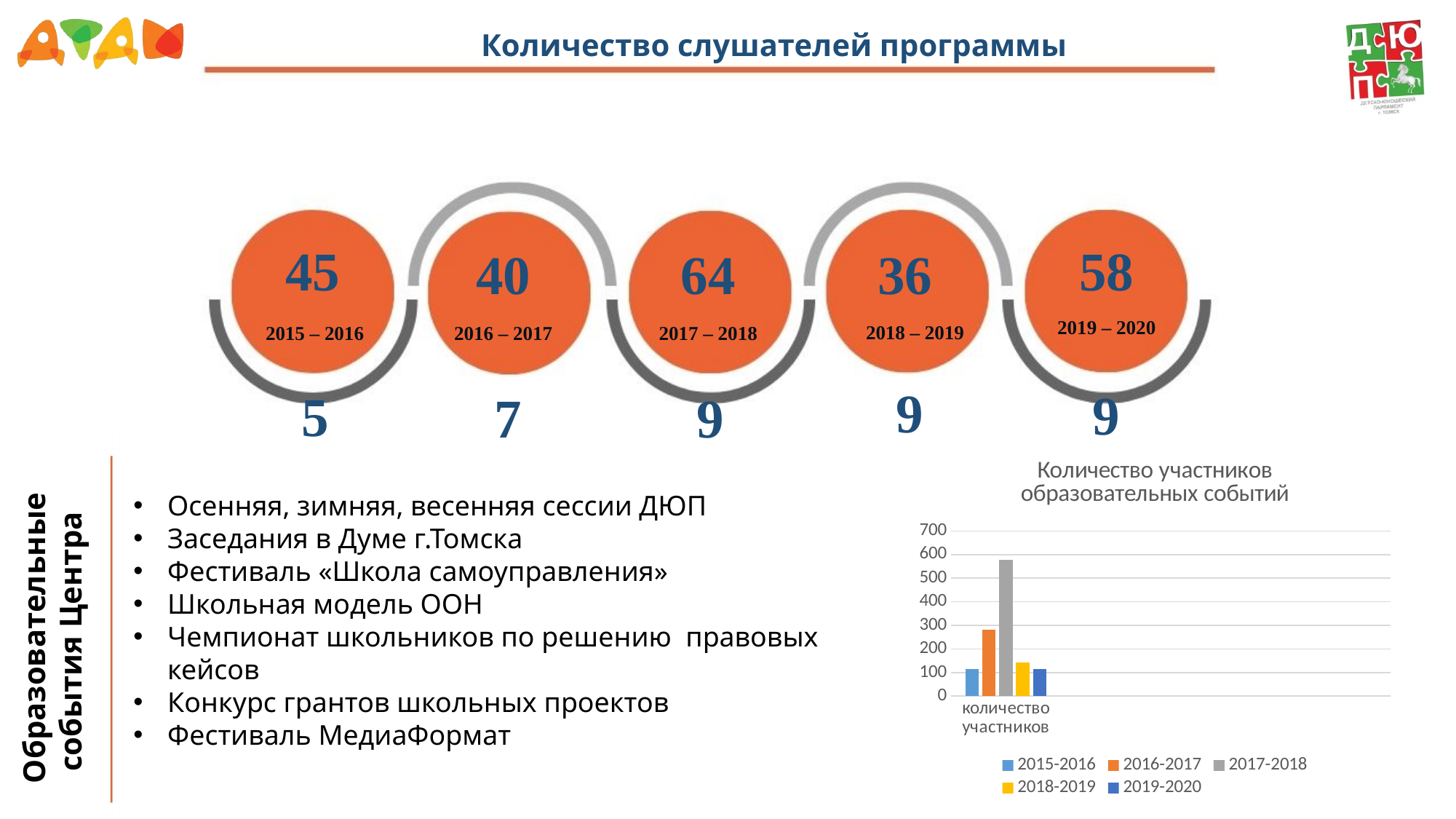
How many categories are shown on the x axis of the chart? 1 Is the value for 2018-2019 greater or less than 200? less What is the title of the chart? Количество участников образовательных событий Which series has the highest value in the chart? 2017-2018 Is the value for 2017-2018 greater or less than 500? greater Is the value for 2016-2017 greater or less than 300? less What colour represents the 2017-2018 series in the chart? grey How many series does the chart legend list? 5 What kind of chart is shown on the slide? bar chart Which is larger, the value for 2016-2017 or the value for 2018-2019? 2016-2017